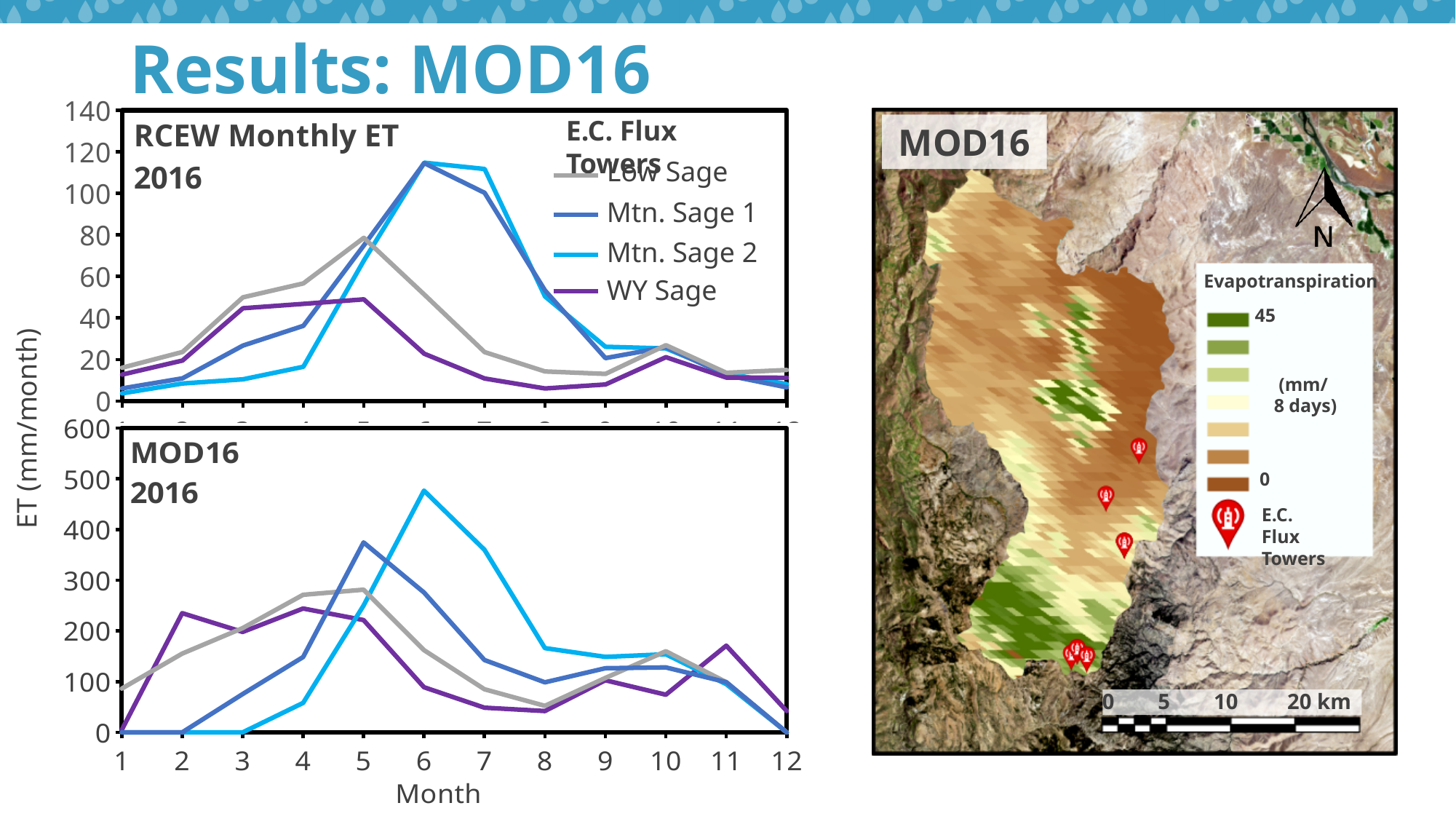
In the RCEW Monthly ET 2016 chart, which series has the lowest peak value? WY Sage In the RCEW Monthly ET 2016 chart, is the value for WY Sage in month 6 greater or less than 40? less In the MOD16 2016 chart, is the value for Mtn. Sage 2 in month 6 greater or less than 400? greater In the RCEW Monthly ET 2016 chart, is the value for Low Sage in month 5 greater or less than 60? greater In the MOD16 2016 chart, what is the value for Mtn. Sage 1 in month 1? 0 In the MOD16 2016 chart, which is larger in month 2: WY Sage or Low Sage? WY Sage In the MOD16 2016 chart, does the Mtn. Sage 2 line rise or fall from month 6 to month 8? fall In the MOD16 2016 chart, which series reaches the highest peak value? Mtn. Sage 2 How many series does the legend list for the line charts? 4 How many months are plotted along the x axis of the MOD16 2016 chart? 12 What is the label on the shared y axis of the two line charts? ET (mm/month) What kind of chart is the RCEW Monthly ET 2016 chart? line chart